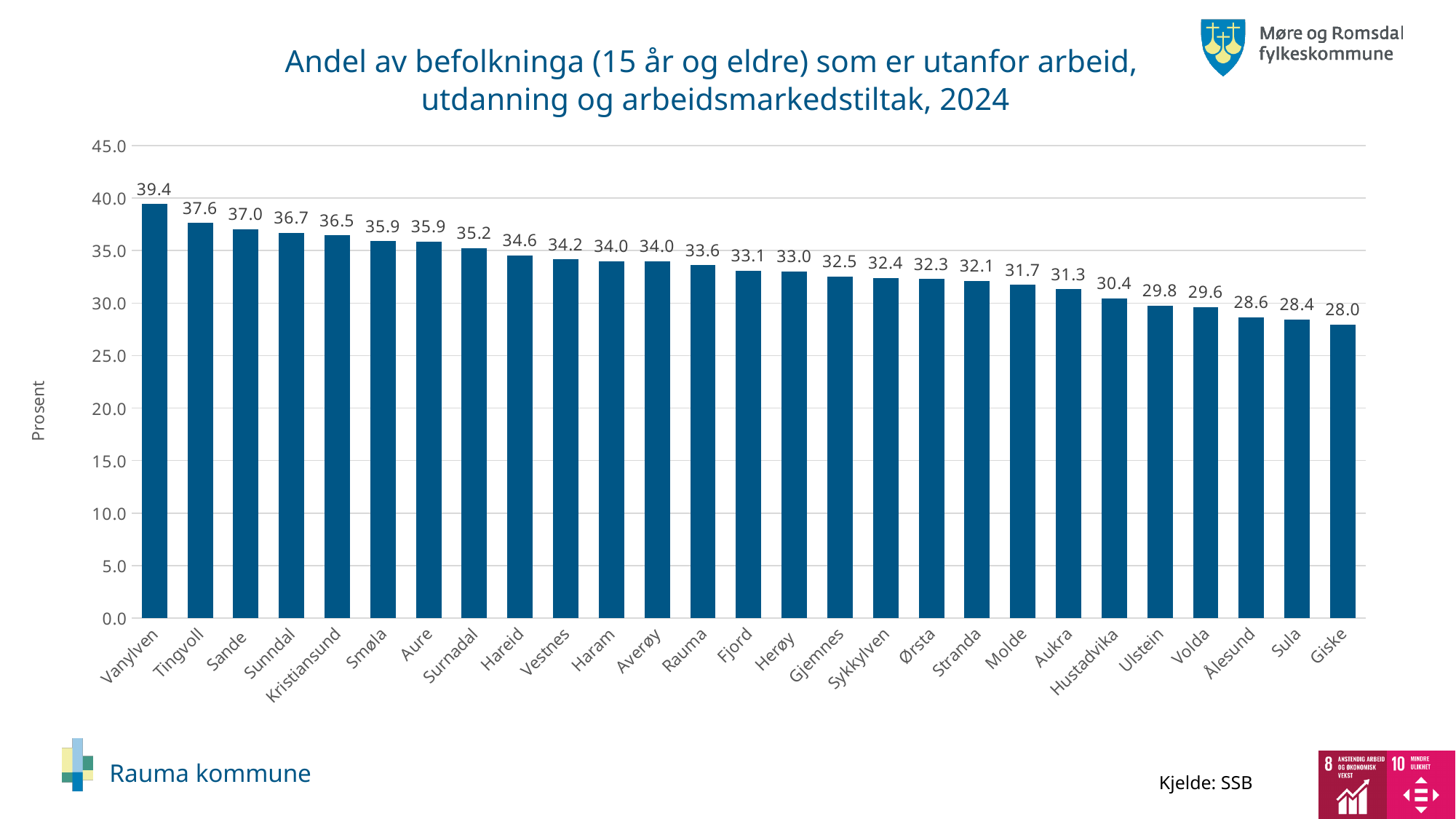
What is the value for Molde? 31.7 Which municipality has the lowest value? Giske What is the difference between the values for Tingvoll and Ålesund? 9.0 Is the value for Ulstein greater or less than 30.0? less What is the difference between the values for Vanylven and Giske? 11.4 What kind of chart is shown on the slide? Bar chart What is the value for Rauma? 33.6 Which has a larger value, Sunndal or Hustadvika? Sunndal What is the label on the vertical axis? Prosent What is the value for Kristiansund? 36.5 Which municipality has the highest value? Vanylven How many municipalities are shown on the chart? 27